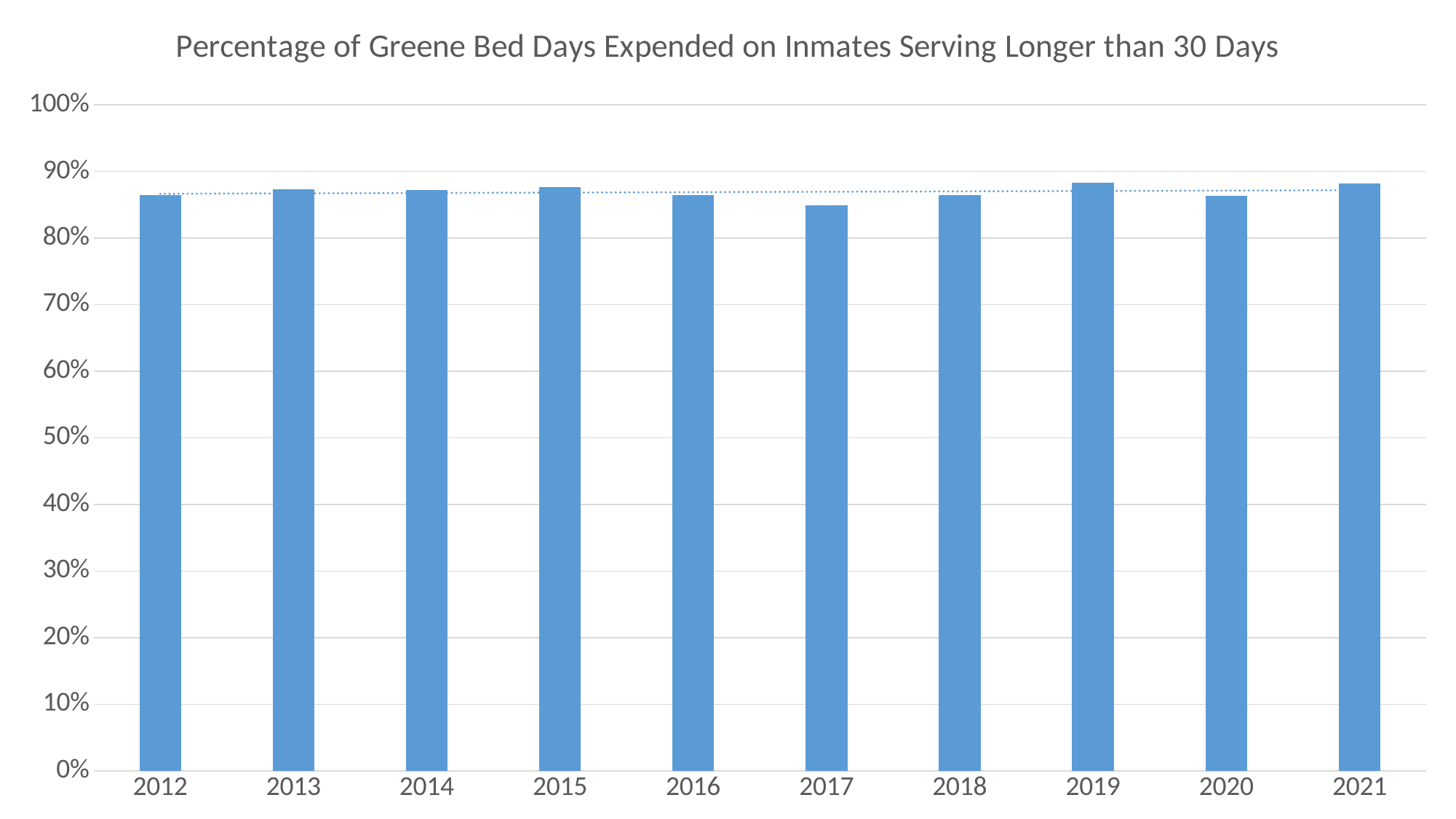
Which year has the lowest percentage of Greene bed days expended on inmates serving longer than 30 days? 2017 Is the value for 2017 greater or less than 80%? greater What is the first year shown on the x axis? 2012 Which is larger, the value for 2019 or the value for 2017? 2019 Is the value for 2021 greater or less than 80%? greater What is the highest value labelled on the y axis? 100% What type of chart is shown on the slide? Bar chart Which is larger, the value for 2017 or the value for 2015? 2015 Is the value for 2019 greater or less than 90%? less How many years are shown on the x axis of the chart? 10 What is the title of the chart? Percentage of Greene Bed Days Expended on Inmates Serving Longer than 30 Days